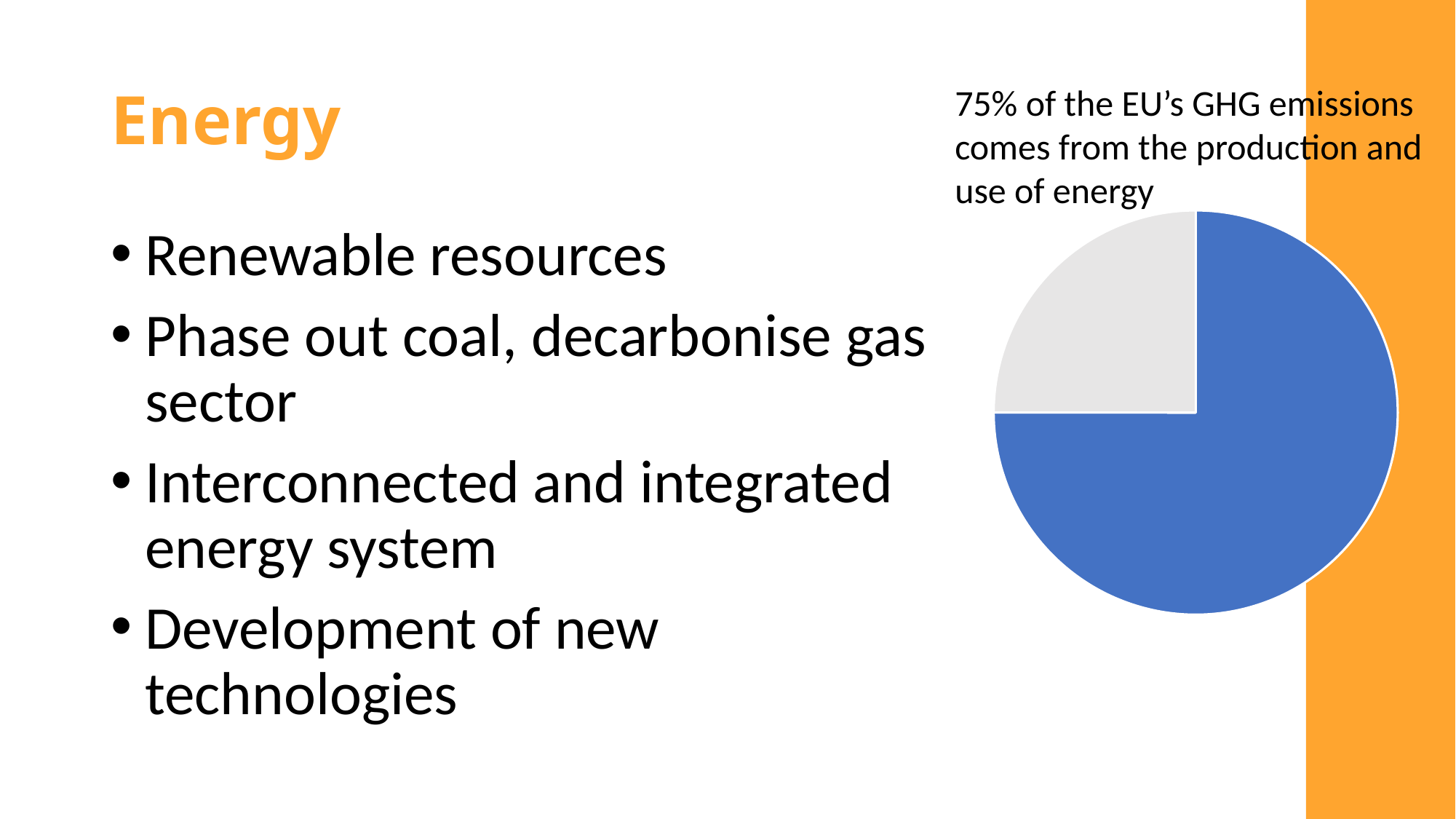
Which slice of the pie chart is the smallest? the grey slice According to the text above the pie chart, what percentage of the EU's GHG emissions comes from the production and use of energy? 75% What does the caption above the pie chart say the 75% share represents? the EU's GHG emissions from the production and use of energy Is the blue slice of the pie chart greater or less than 50% of the pie? greater What kind of chart is shown on the right of the slide? pie chart What colour is the larger slice of the pie chart? blue What share of the pie does the blue slice represent? 75% Which slice of the pie chart is the largest? the blue slice What share of the pie does the grey slice represent? 25% Which is larger in the pie chart, the blue slice or the grey slice? the blue slice How many slices does the pie chart have? 2